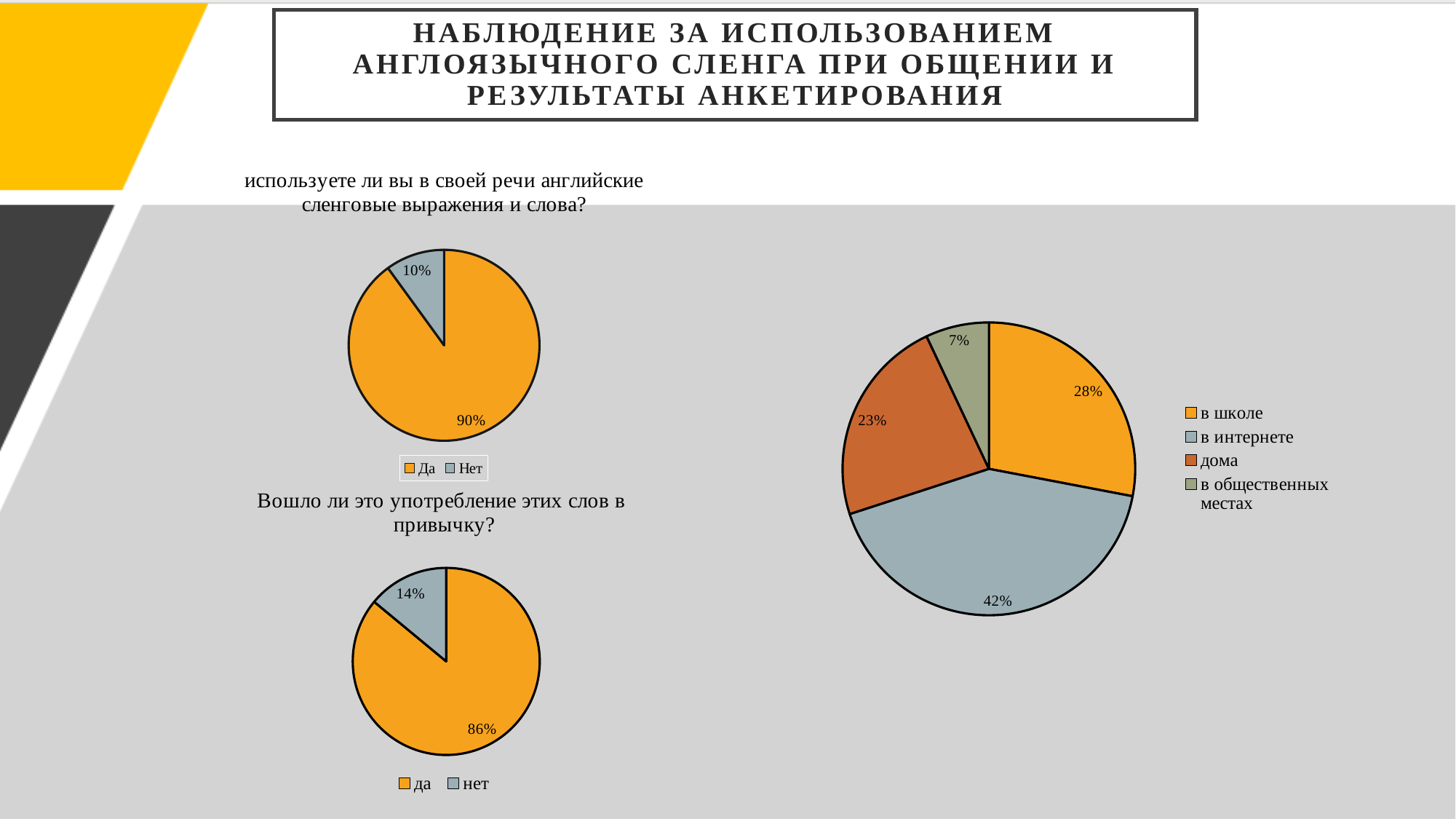
In the bottom-left pie chart ("Вошло ли это употребление этих слов в привычку?"), what is the difference between the "да" and "нет" shares? 72% In the pie chart on the right side of the slide, which category has the smallest share? в общественных местах In the top-left pie chart ("используете ли вы в своей речи английские сленговые выражения и слова?"), what share answered "Нет"? 10% In the pie chart on the right side of the slide, which category has the largest share? в интернете How many categories does the legend of the pie chart on the right side of the slide list? 4 In the pie chart on the right side of the slide, what share corresponds to "в интернете"? 42% In the bottom-left pie chart ("Вошло ли это употребление этих слов в привычку?"), what share answered "да"? 86% In the pie chart on the right side of the slide, which is larger: "в школе" or "дома"? в школе What type of chart is used for "Вошло ли это употребление этих слов в привычку?"? Pie chart In the pie chart on the right side of the slide, what is the difference between the "в интернете" and "в школе" shares? 14% In the pie chart on the right side of the slide, what share corresponds to "дома"? 23% In the top-left pie chart ("используете ли вы в своей речи английские сленговые выражения и слова?"), what share answered "Да"? 90%